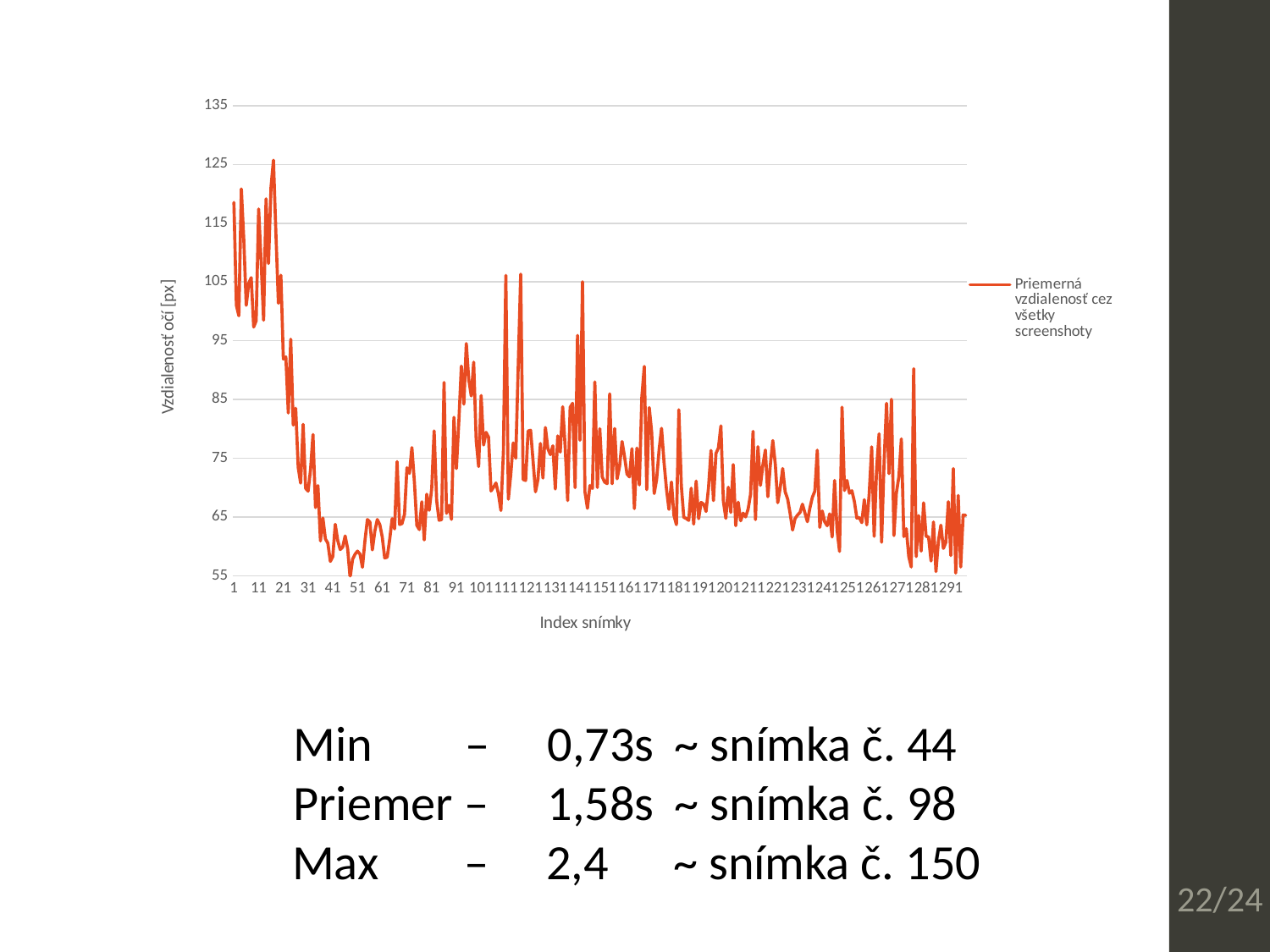
Is the value at index 51 greater or less than 65? less Is the value at index 41 greater or less than 75? less What kind of chart is shown on the slide? line chart Is the value at index 1 greater or less than 115? greater Which is larger, the value at index 141 or the value at index 281? index 141 What is the name of the series shown in the legend? Priemerná vzdialenosť cez všetky screenshoty What is the title of the vertical axis? Vzdialenosť očí [px] Overall, do the values rise or fall from the start of the x axis (index 1) to the end (index 291)? fall How many series does the legend list? 1 Which is larger, the value at index 1 or the value at index 51? index 1